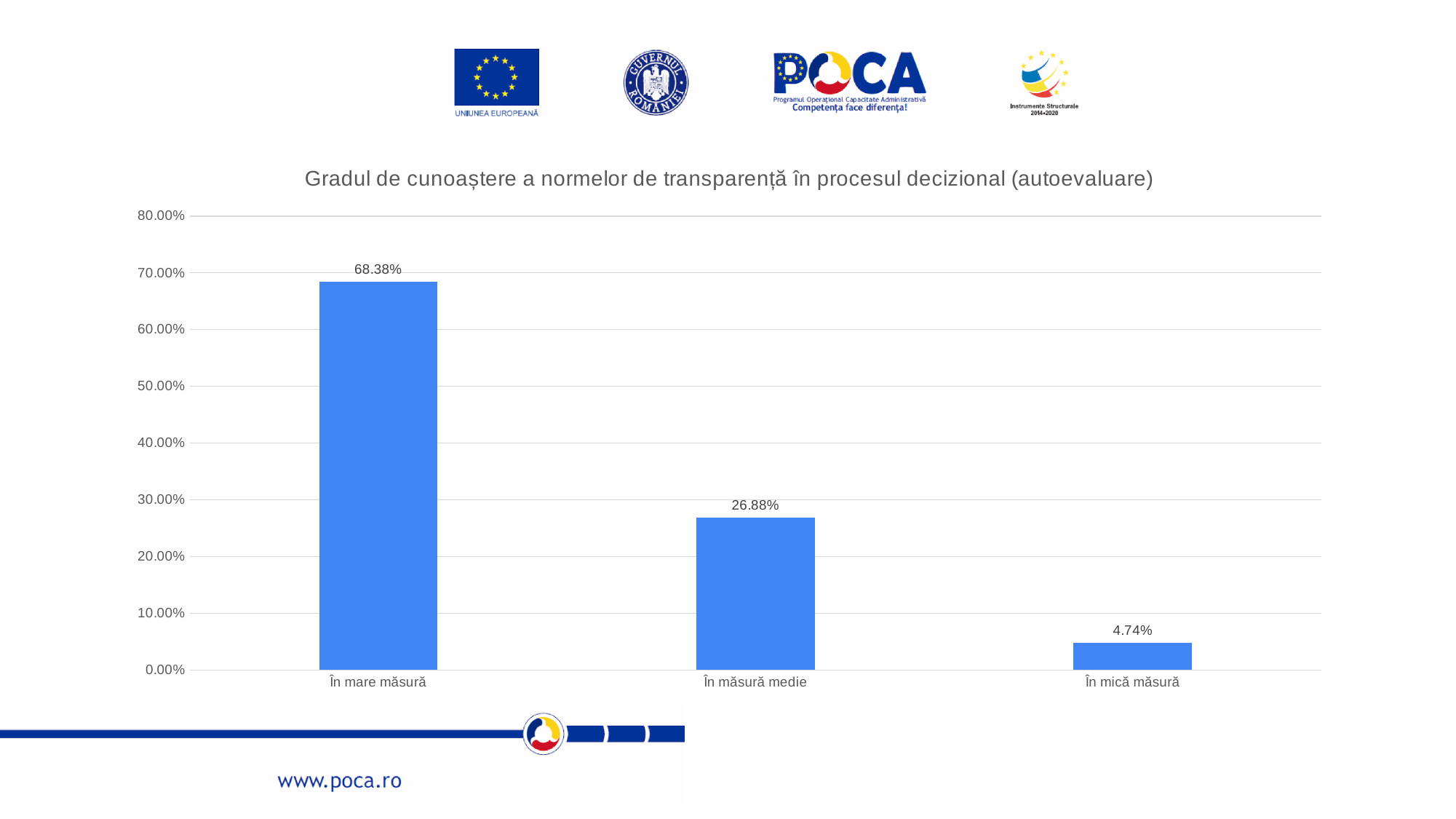
What is the value for "În mică măsură"? 4.74% What is the value for "În măsură medie"? 26.88% Which is larger, the value for "În măsură medie" or the value for "În mică măsură"? În măsură medie What is the difference between the values for "În mare măsură" and "În măsură medie"? 41.50% Which category has the highest value? În mare măsură How many categories are shown on the x axis? 3 What is the title of the chart? Gradul de cunoaștere a normelor de transparență în procesul decizional (autoevaluare) What kind of chart is shown on the slide? Bar chart What is the value for "În mare măsură"? 68.38% Which category has the lowest value? În mică măsură What is the difference between the values for "În măsură medie" and "În mică măsură"? 22.14% Is the value for "În măsură medie" greater or less than 30.00%? less